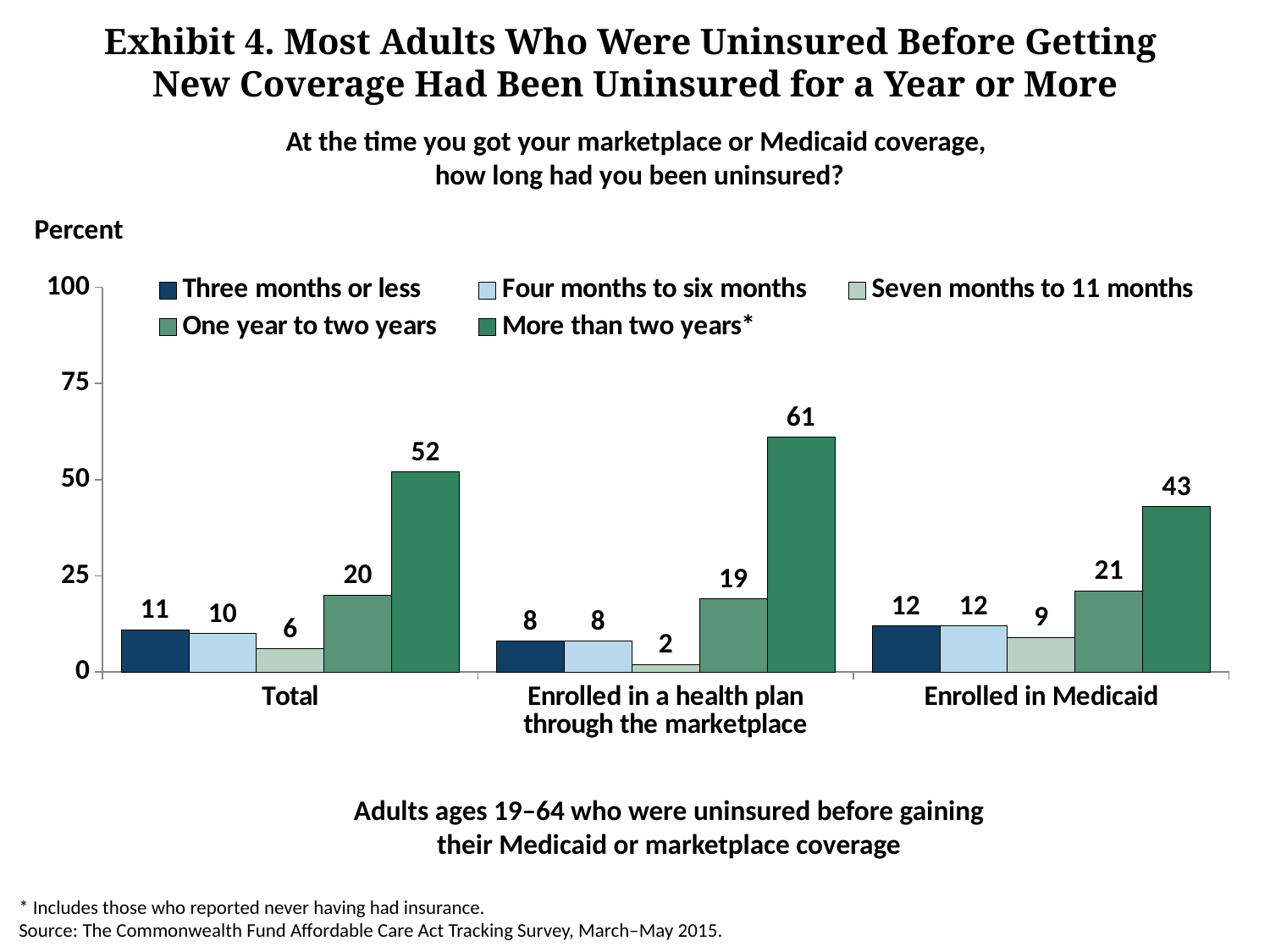
What is the value for "Seven months to 11 months" among those enrolled in a health plan through the marketplace? 2 What is the difference between "One year to two years" and "Four months to six months" in the Total group? 10 What kind of chart is shown on the slide? Bar chart What is the value for "More than two years*" in the Total group? 52 Which is larger: "Three months or less" for Total or "Three months or less" for Enrolled in Medicaid? Enrolled in Medicaid What is the difference between the "More than two years*" values for the marketplace group and the Medicaid group? 18 How many series does the legend list? 5 What is the value for "One year to two years" among those enrolled in Medicaid? 21 Which series has the lowest value in the Total group? Seven months to 11 months How many categories are shown on the x axis? 3 What is the label on the y axis of the chart? Percent Which category has the highest value for "More than two years*"? Enrolled in a health plan through the marketplace